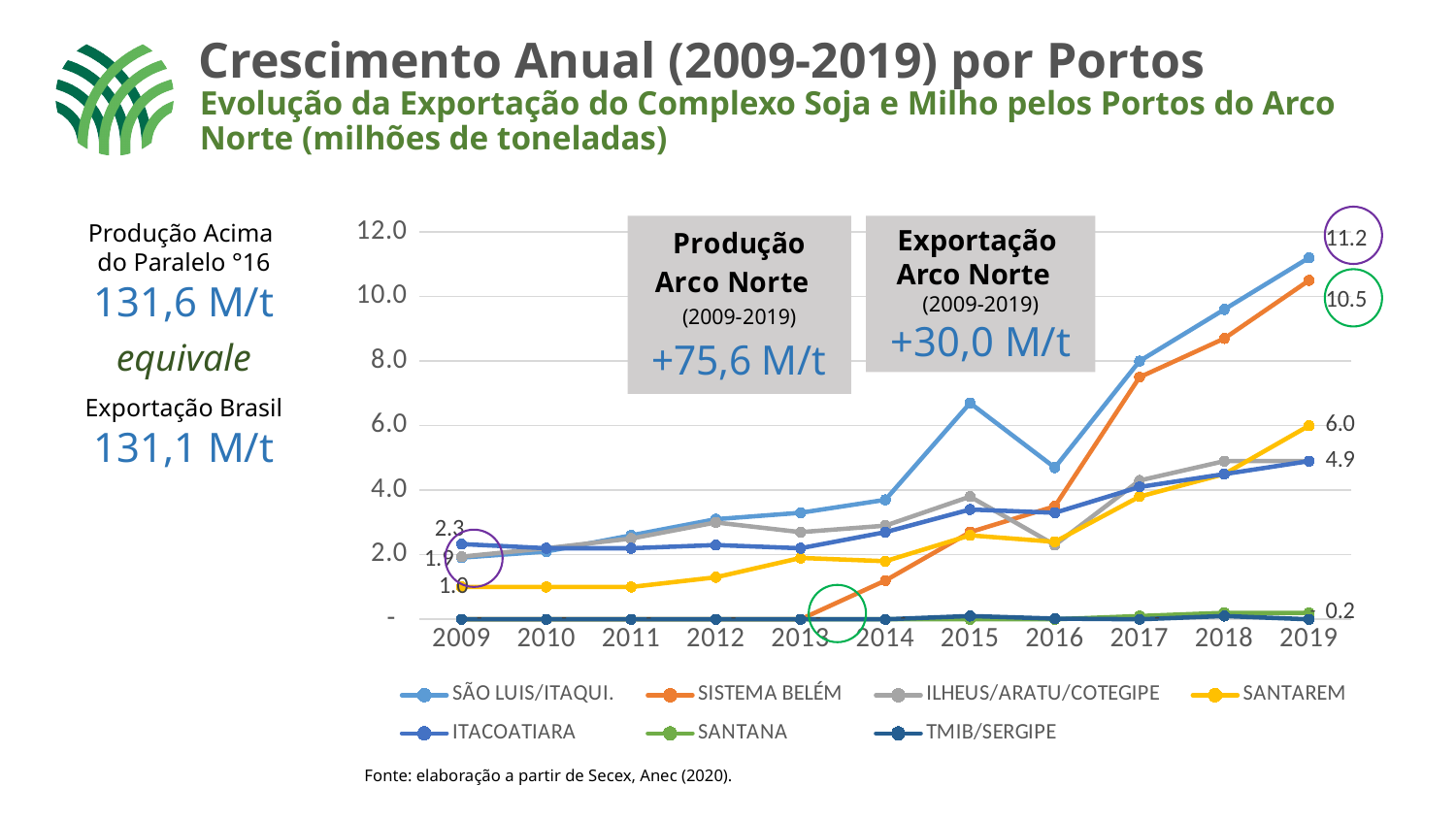
What is the value for SÃO LUIS/ITAQUI. in 2019? 11.2 What is the difference between the 2019 values of SÃO LUIS/ITAQUI. and SISTEMA BELÉM? 0.7 How many series does the legend list? 7 How many years are plotted along the x axis? 11 What kind of chart is shown on the slide? line chart Is the value for SISTEMA BELÉM in 2014 greater or less than 2.0? less Is the value for SÃO LUIS/ITAQUI. in 2015 greater or less than 6.0? greater Which is larger in 2019, SANTAREM or SISTEMA BELÉM? SISTEMA BELÉM What is the value for SANTAREM in 2019? 6.0 What is the value for SISTEMA BELÉM in 2019? 10.5 Which port has the highest value in 2019? SÃO LUIS/ITAQUI. What is the value for SÃO LUIS/ITAQUI. in 2009? 1.9